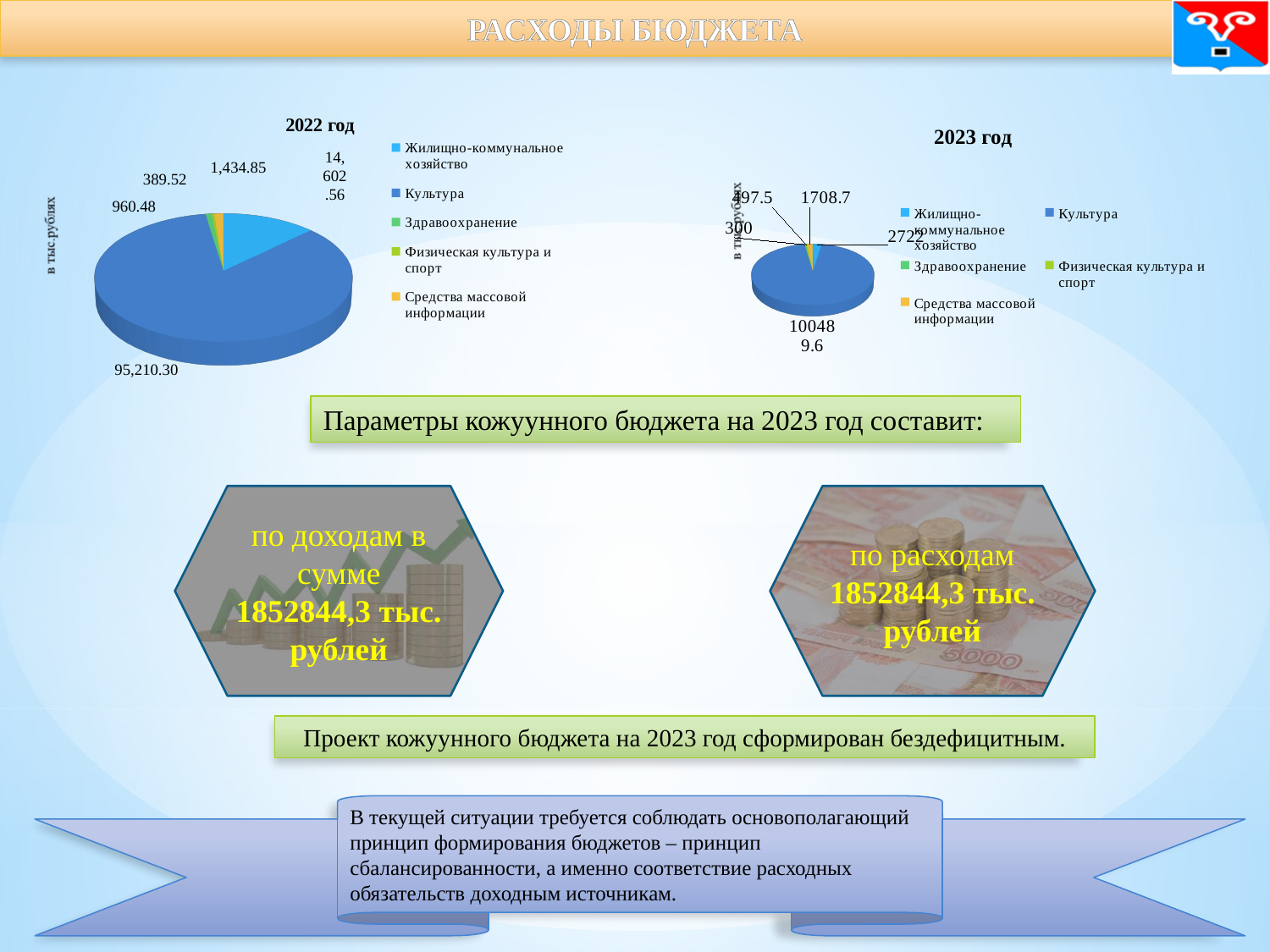
In the "2022 год" chart, which is larger: Культура or Жилищно-коммунальное хозяйство? Культура In the "2022 год" chart, what is the difference between the values for Культура and Жилищно-коммунальное хозяйство? 80,607.74 What is the title of the pie chart on the right side of the slide? 2023 год How many series does the legend of the "2022 год" chart list? 5 What is the smallest value labelled on the "2023 год" chart? 300 In the "2022 год" chart, what is the value for Культура? 95,210.30 In the "2023 год" chart, which category has the largest slice? Культура How many categories does the legend of the "2023 год" chart list? 5 In the "2022 год" chart, which category has the largest slice? Культура In the "2022 год" chart, what is the value for Жилищно-коммунальное хозяйство? 14,602.56 What type of chart is the "2022 год" chart on the left? Pie chart What is the smallest value labelled on the "2022 год" chart? 389.52